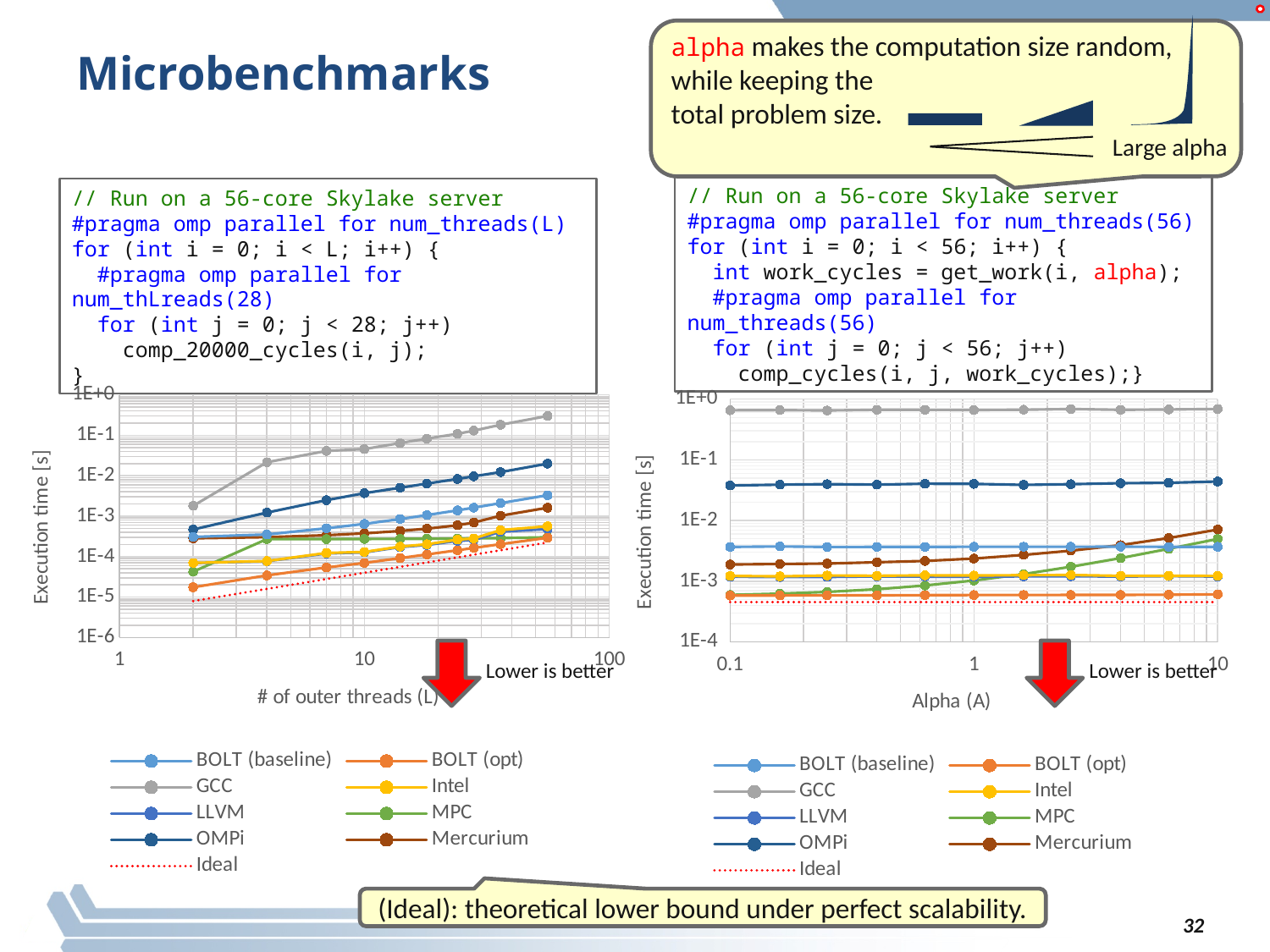
In the left chart (x axis '# of outer threads (L)'), does the GCC execution time rise or fall as the number of outer threads increases? rise In the left chart (x axis '# of outer threads (L)'), which series has the highest execution time across the plotted range? GCC In the right chart (x axis 'Alpha (A)'), is the OMPi execution time greater or less than 1E-2? greater How many series does the legend of the right chart (x axis 'Alpha (A)') list? 9 What is the y-axis label of the left chart (x axis '# of outer threads (L)')? Execution time [s] In the right chart (x axis 'Alpha (A)'), is the Ideal execution time greater or less than 1E-3? less What kind of chart is the left chart (x axis '# of outer threads (L)')? line chart In the right chart (x axis 'Alpha (A)'), which series has the larger execution time, GCC or OMPi? GCC In the right chart (x axis 'Alpha (A)'), does the MPC execution time rise or fall as alpha increases? rise In the right chart (x axis 'Alpha (A)'), is the GCC execution time greater or less than 1E-1? greater In the right chart (x axis 'Alpha (A)'), which series has the lowest execution time across the plotted range? Ideal